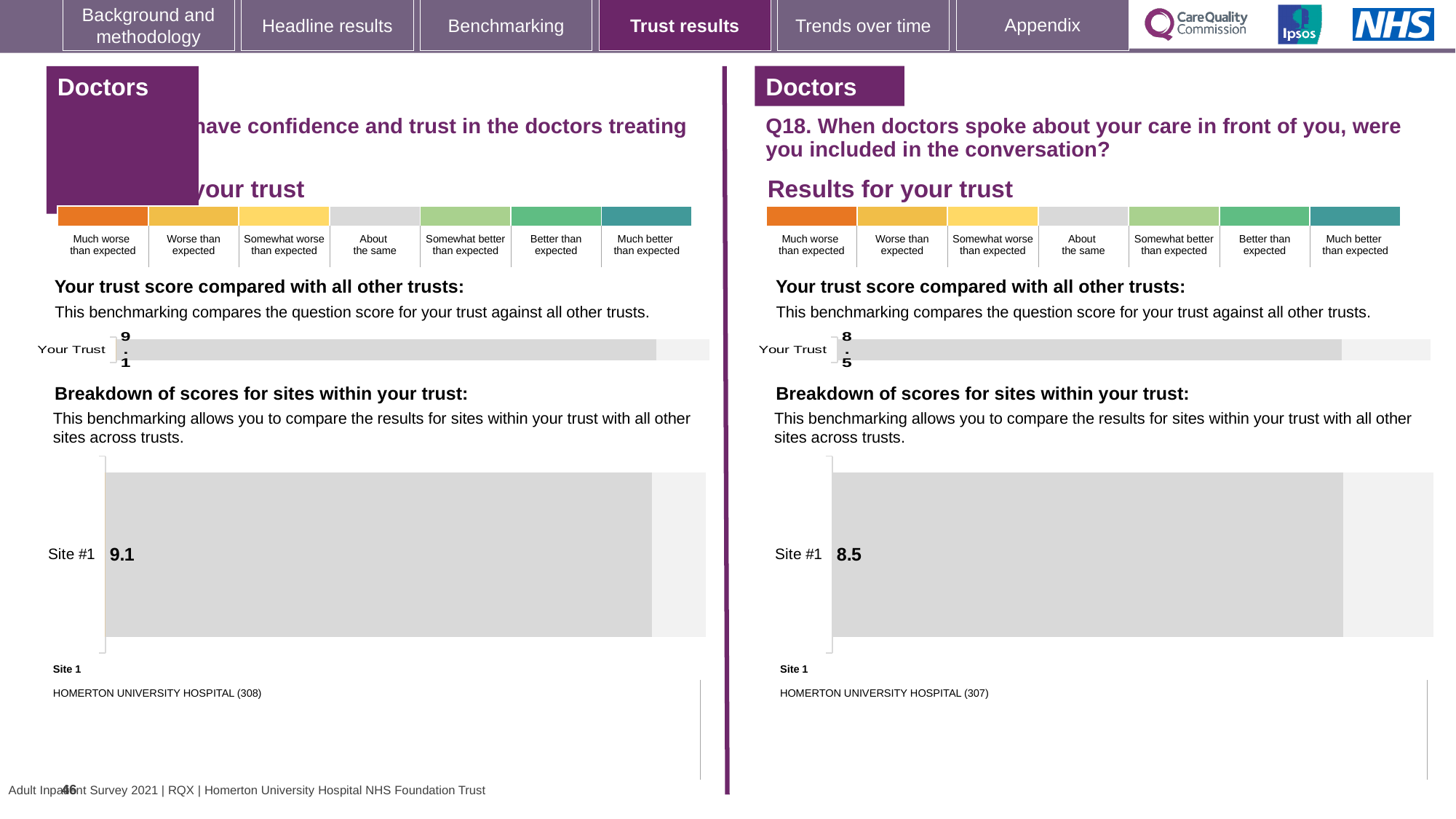
What kind of chart is the left-hand 'Breakdown of scores for sites within your trust' chart? Bar chart Which site is listed as Site 1 beneath the right-hand 'Breakdown of scores for sites within your trust' chart? HOMERTON UNIVERSITY HOSPITAL (307) Which is larger: the Your Trust score on the left-hand chart or the Your Trust score on the right-hand Q18 chart? The left-hand chart (9.1) What kind of chart is the right-hand 'Your trust score compared with all other trusts' chart? Bar chart On the right-hand 'Breakdown of scores for sites within your trust' chart (Q18), what is the value for Site #1? 8.5 How many sites are shown on the right-hand 'Breakdown of scores for sites within your trust' chart? 1 How many bars are plotted on the left-hand 'Your trust score compared with all other trusts' chart? 1 On the left-hand 'Your trust score compared with all other trusts' chart, what is the value for Your Trust? 9.1 On the right-hand 'Your trust score compared with all other trusts' chart (Q18), what is the value for Your Trust? 8.5 What is the difference between the Site #1 score on the left-hand breakdown chart and the Site #1 score on the right-hand Q18 breakdown chart? 0.6 Which site is listed as Site 1 beneath the left-hand 'Breakdown of scores for sites within your trust' chart? HOMERTON UNIVERSITY HOSPITAL (308) On the left-hand 'Breakdown of scores for sites within your trust' chart, what is the value for Site #1? 9.1